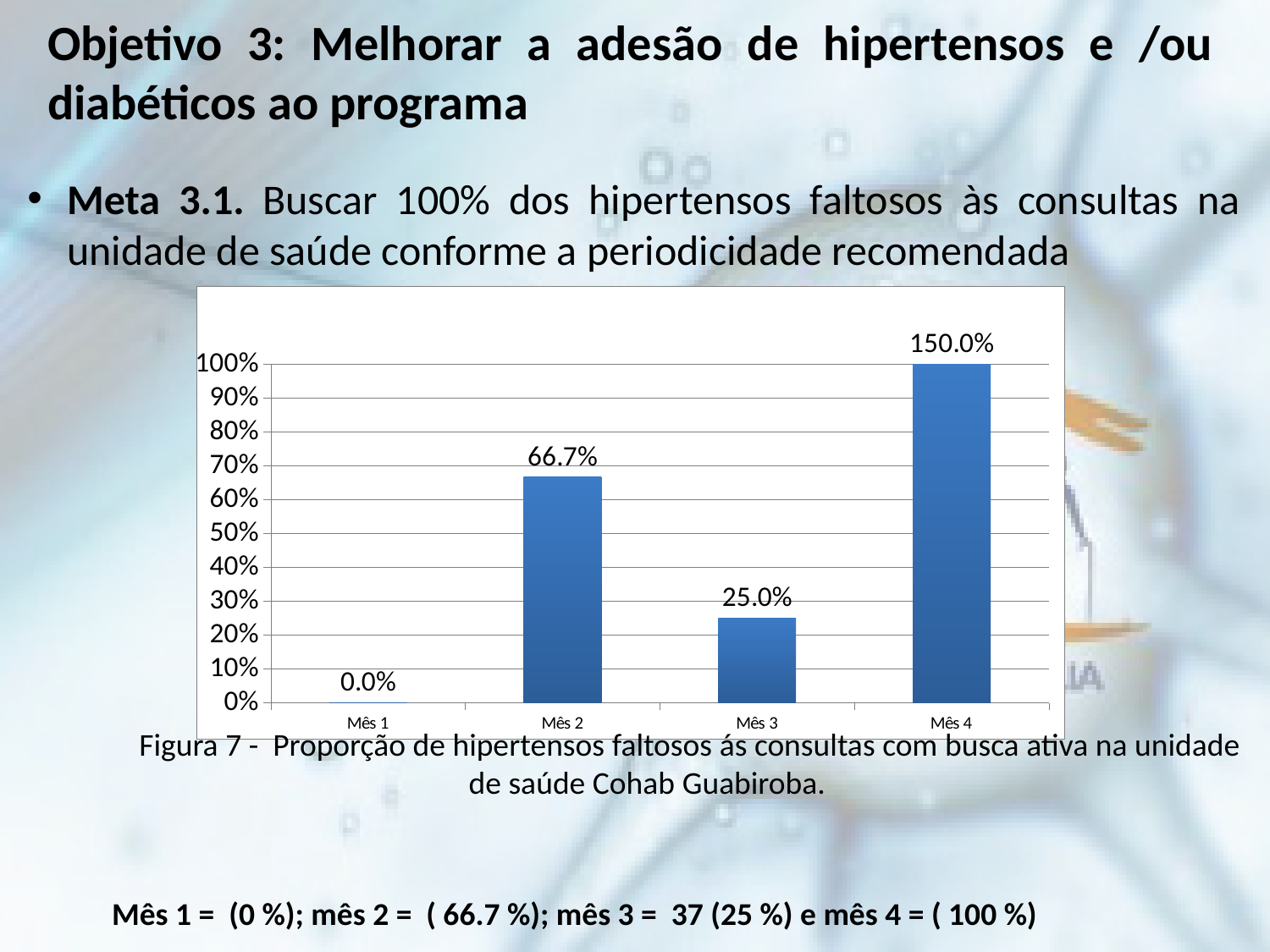
What is the difference between the values for Mês 2 and Mês 3? 41.7% What is the highest tick value shown on the y axis? 100% What is the value for Mês 1? 0.0% Which month has the lowest value? Mês 1 What kind of chart is shown on the slide? bar chart What is the value for Mês 2? 66.7% What data label is shown above the bar for Mês 4? 150.0% Is the value for Mês 3 greater or less than 30%? less How many months are shown on the x axis? 4 Which month has the highest value? Mês 4 Which is larger, the value for Mês 2 or the value for Mês 3? Mês 2 What is the value for Mês 3? 25.0%